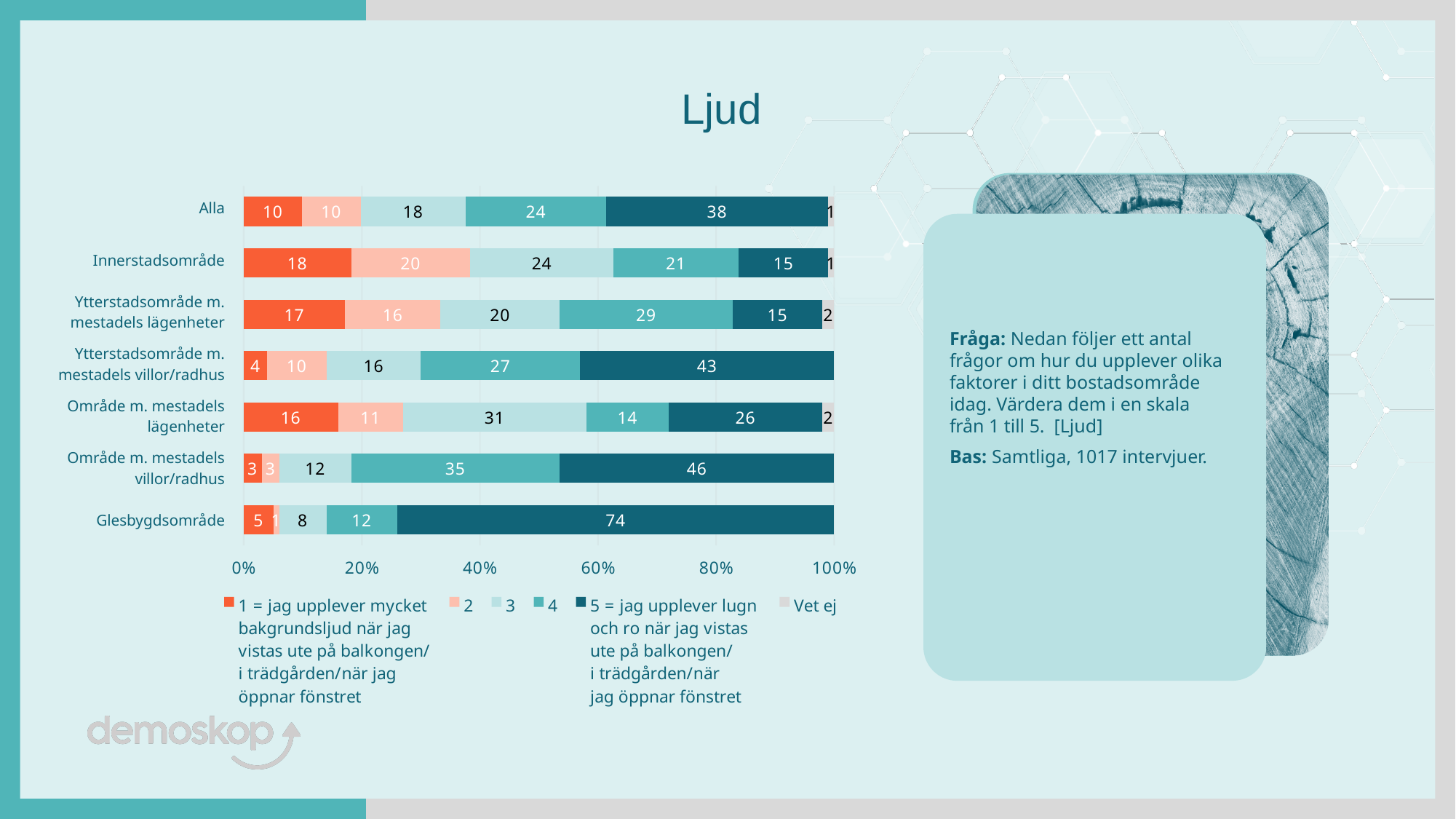
What is the value for series '4' for Ytterstadsområde m. mestadels villor/radhus? 27 Which category has the lowest value for '1 = jag upplever mycket bakgrundsljud...'? Område m. mestadels villor/radhus What is the value for series '3' for Område m. mestadels lägenheter? 31 What is the value for '5 = jag upplever lugn och ro...' for Glesbygdsområde? 74 How many series does the legend list? 6 What is the value for series '2' for Innerstadsområde? 20 How many categories are shown on the y axis of the chart? 7 What kind of chart is shown on the slide? Stacked bar chart Which category has the highest value for '5 = jag upplever lugn och ro...'? Glesbygdsområde What is the difference between the '5' value for Glesbygdsområde and the '5' value for Alla? 36 What is the title of the chart? Ljud Which is larger: the '1' value for Innerstadsområde or the '1' value for Ytterstadsområde m. mestadels lägenheter? Innerstadsområde